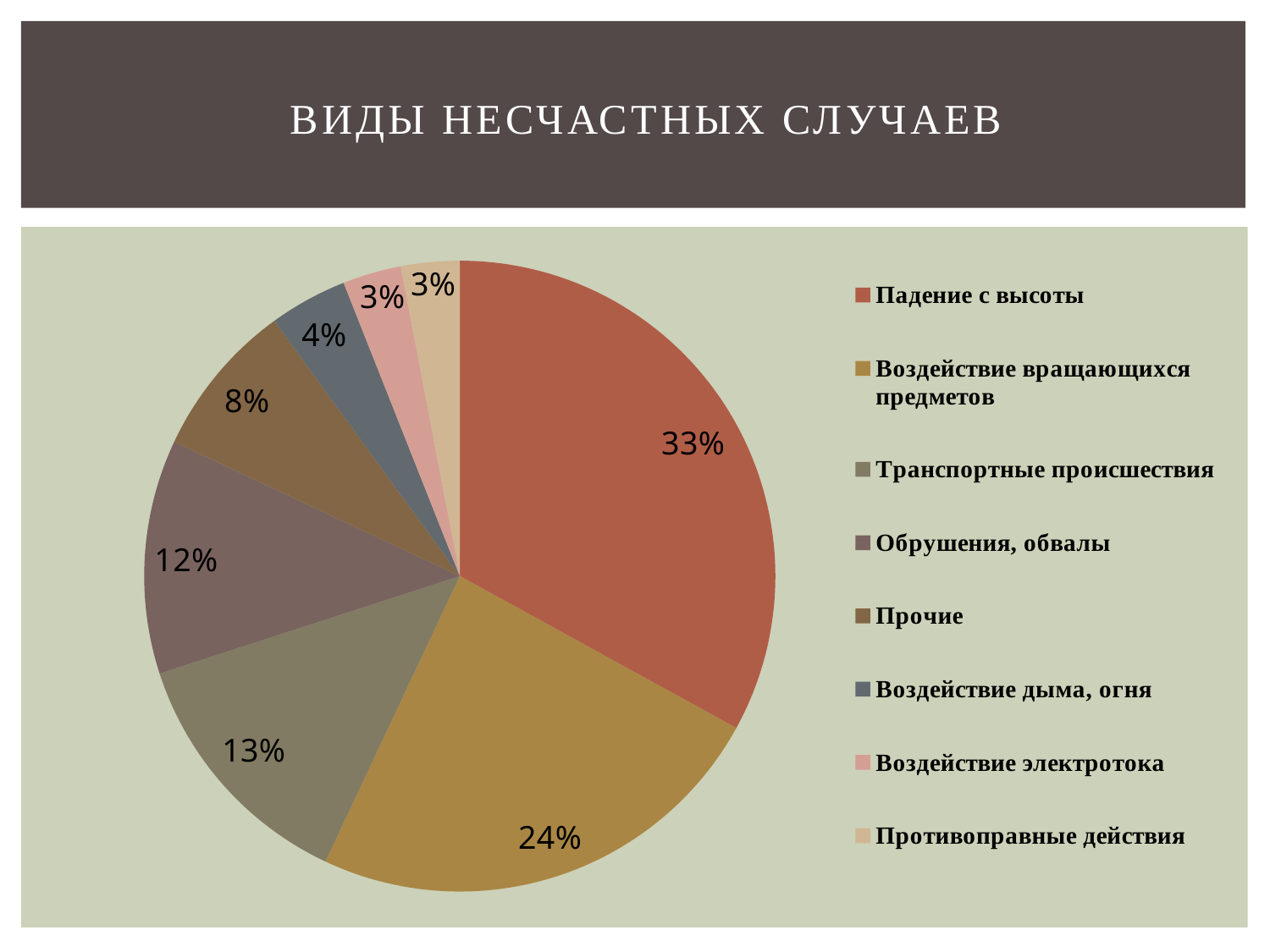
What share of the pie does "Падение с высоты" take? 33% What is the value for "Обрушения, обвалы"? 12% What share of the pie does "Воздействие вращающихся предметов" take? 24% What kind of chart is shown on the slide? Pie chart What is the value for "Транспортные происшествия"? 13% Which category has the largest slice of the pie? Падение с высоты How many categories does the legend list? 8 What is the value for "Воздействие дыма, огня"? 4% What is the chart's title? ВИДЫ НЕСЧАСТНЫХ СЛУЧАЕВ Which is larger, the share for "Транспортные происшествия" or the share for "Прочие"? Транспортные происшествия What is the difference between the shares of "Падение с высоты" and "Воздействие вращающихся предметов"? 9% What is the value for "Прочие"? 8%